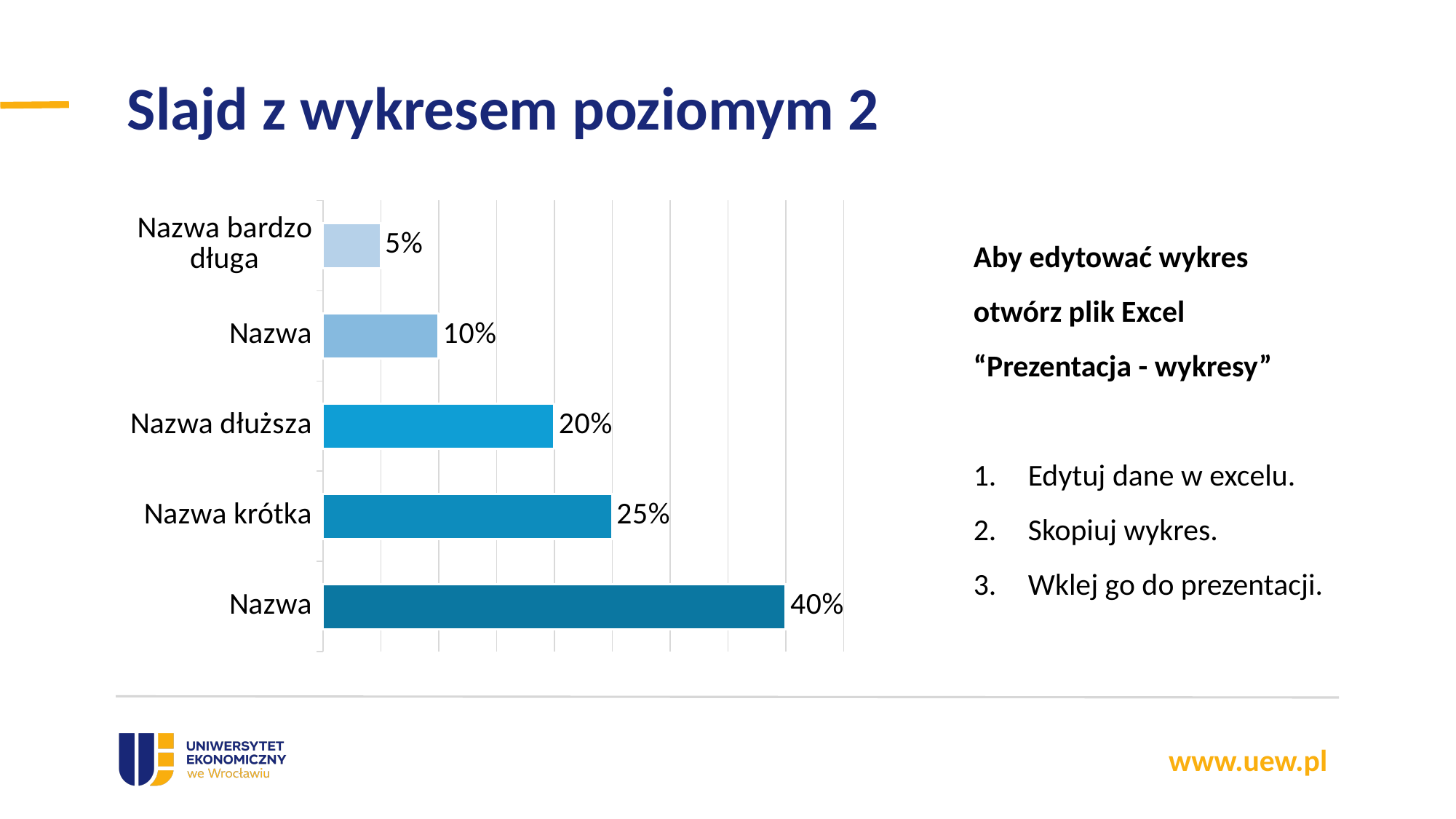
What is the value of the bottom bar, labelled "Nazwa"? 40% What is the difference between the values for "Nazwa krótka" and "Nazwa dłuższa"? 5% What is the difference between the largest bar (40%) and the smallest bar (5%)? 35% What is the value for "Nazwa krótka"? 25% What is the value for "Nazwa bardzo długa"? 5% What kind of chart is shown on the slide? bar chart Does the chart show a legend? No Which category has the highest value? Nazwa (bottom bar) Which category has the lowest value? Nazwa bardzo długa How many bars does the chart have? 5 Which is larger, the value for "Nazwa dłuższa" or the value for "Nazwa bardzo długa"? Nazwa dłuższa What is the value for "Nazwa dłuższa"? 20%